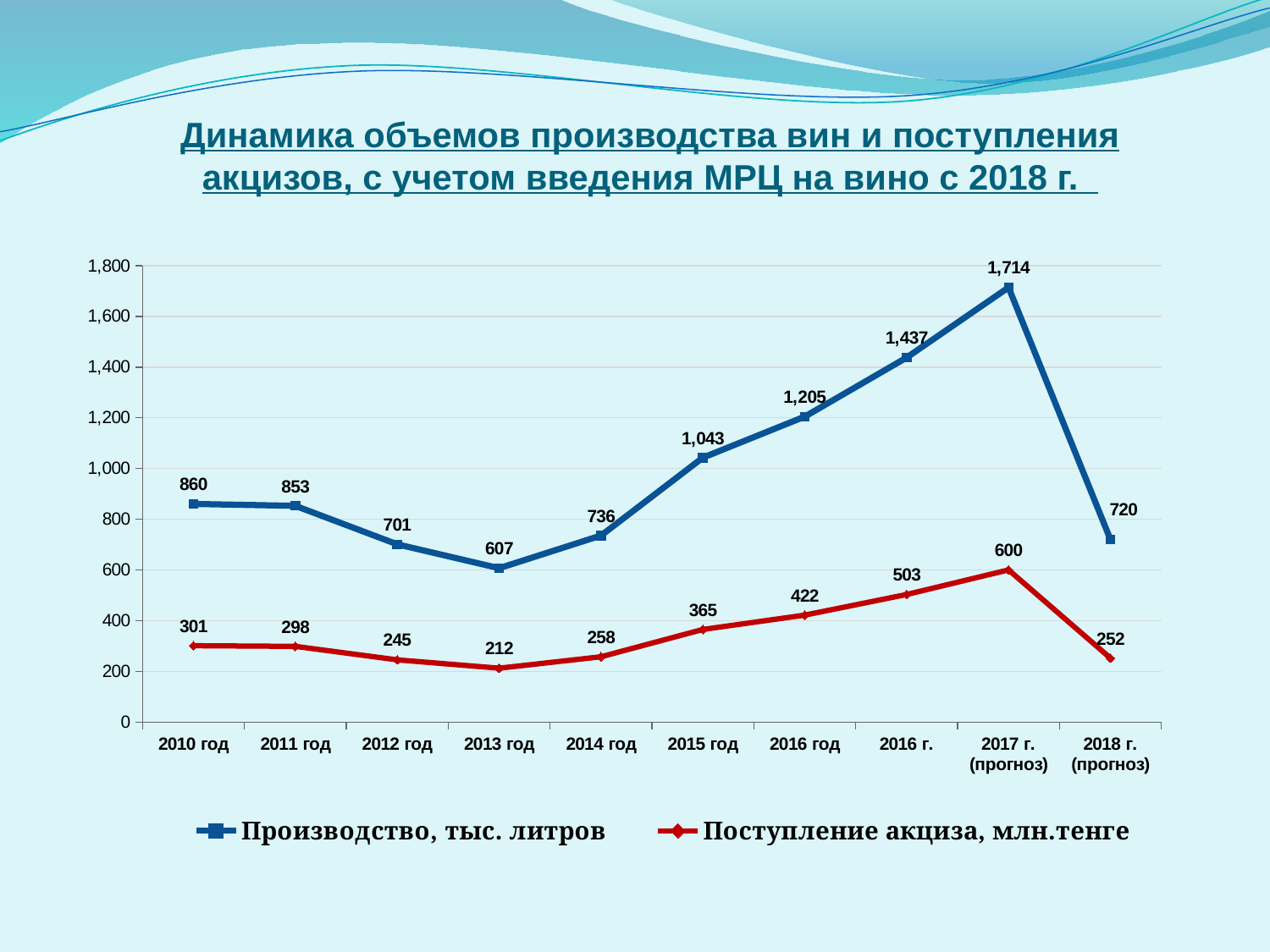
Which is larger: Поступление акциза, млн.тенге for 2010 год or for 2011 год? 2010 год What kind of chart is shown on the slide? line chart Does Поступление акциза, млн.тенге rise or fall from 2013 год to 2017 г. (прогноз)? rise Which category has the lowest value for Поступление акциза, млн.тенге? 2013 год What is the difference between Производство, тыс. литров for 2017 г. (прогноз) and 2018 г. (прогноз)? 994 What is the value of Поступление акциза, млн.тенге for 2016 год? 422 What is the value of Производство, тыс. литров for 2018 г. (прогноз)? 720 Which category has the highest value for Производство, тыс. литров? 2017 г. (прогноз) What colour is the line for Производство, тыс. литров? blue What is the value of Производство, тыс. литров for 2013 год? 607 How many categories are shown on the x axis? 10 How many series does the legend list? 2